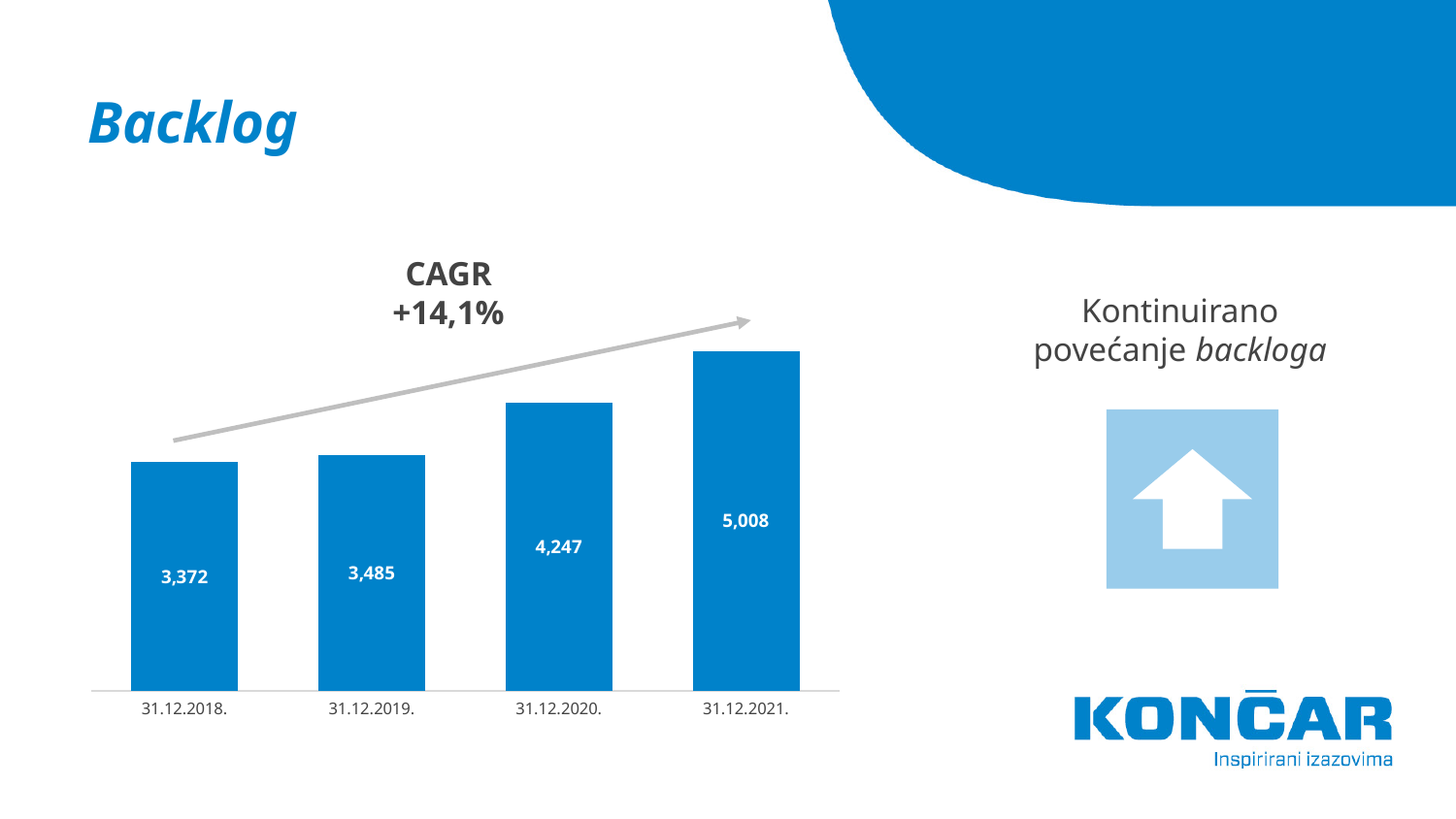
Which is larger, the backlog at 31.12.2020. or at 31.12.2019.? 31.12.2020. Which date has the highest backlog value? 31.12.2021. What is the backlog value at 31.12.2020.? 4,247 What is the backlog value at 31.12.2021.? 5,008 What CAGR is stated on the chart? +14,1% What is the difference between the backlog at 31.12.2019. and at 31.12.2018.? 113 Which date has the lowest backlog value? 31.12.2018. What kind of chart is shown on the slide? Bar chart What is the backlog value at 31.12.2018.? 3,372 How many dates are shown on the x axis of the chart? 4 What is the backlog value at 31.12.2019.? 3,485 What is the difference between the backlog at 31.12.2021. and at 31.12.2020.? 761